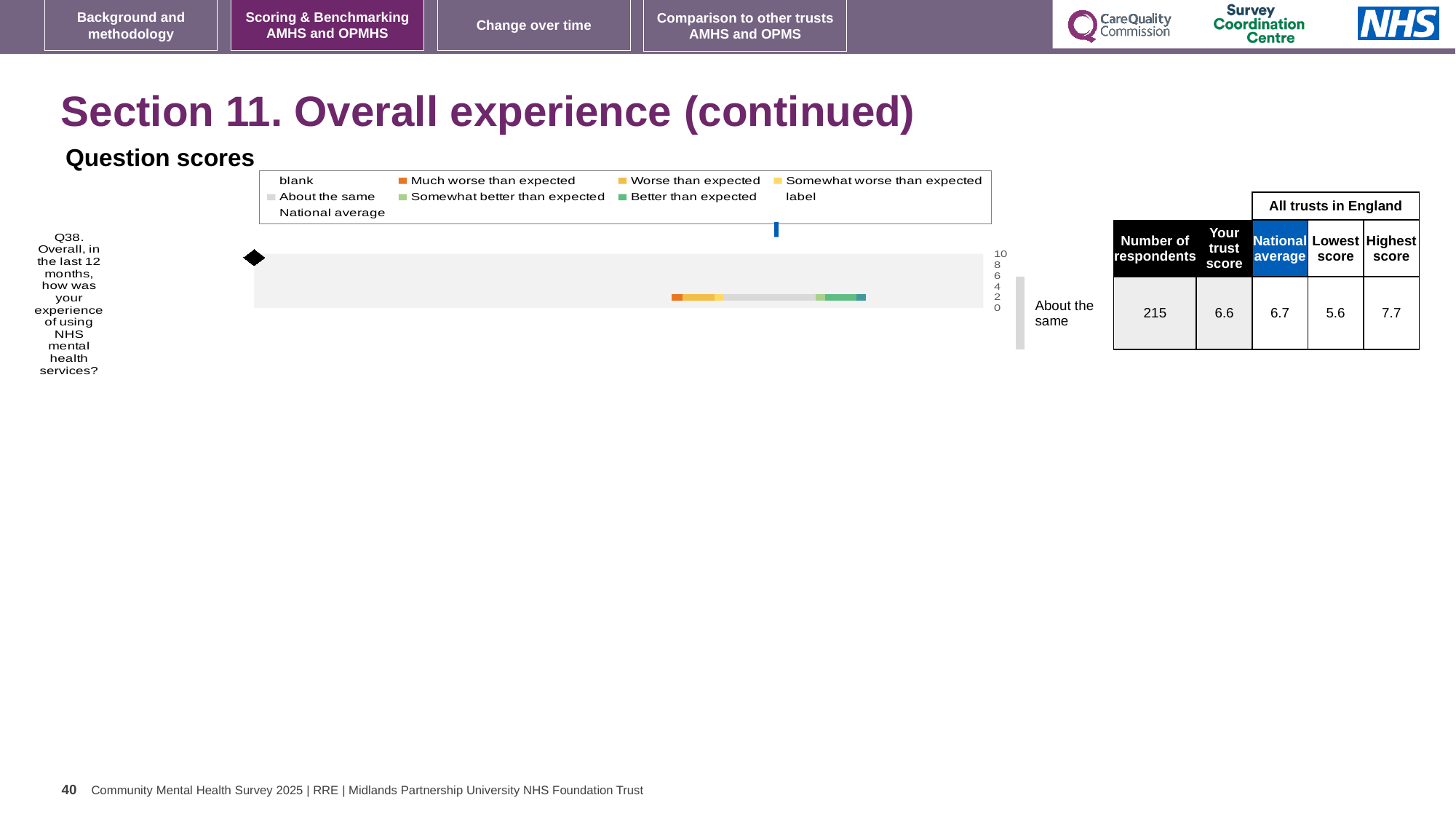
What kind of chart is shown under 'Question scores'? bar chart How many questions are plotted in the Question scores chart? 1 How many respondents answered Q38? 215 How is the trust's Q38 score categorised relative to other trusts? About the same Which question is plotted in the Question scores chart? Q38. Overall, in the last 12 months, how was your experience of using NHS mental health services? What is the lowest score among all trusts in England for Q38? 5.6 What is the highest value shown on the chart's score axis? 10 What is the trust's score for Q38? 6.6 Which is larger for Q38: the trust's score or the national average? national average What is the national average score for Q38? 6.7 What is the highest score among all trusts in England for Q38? 7.7 What is the difference between the highest and lowest trust scores in England for Q38? 2.1